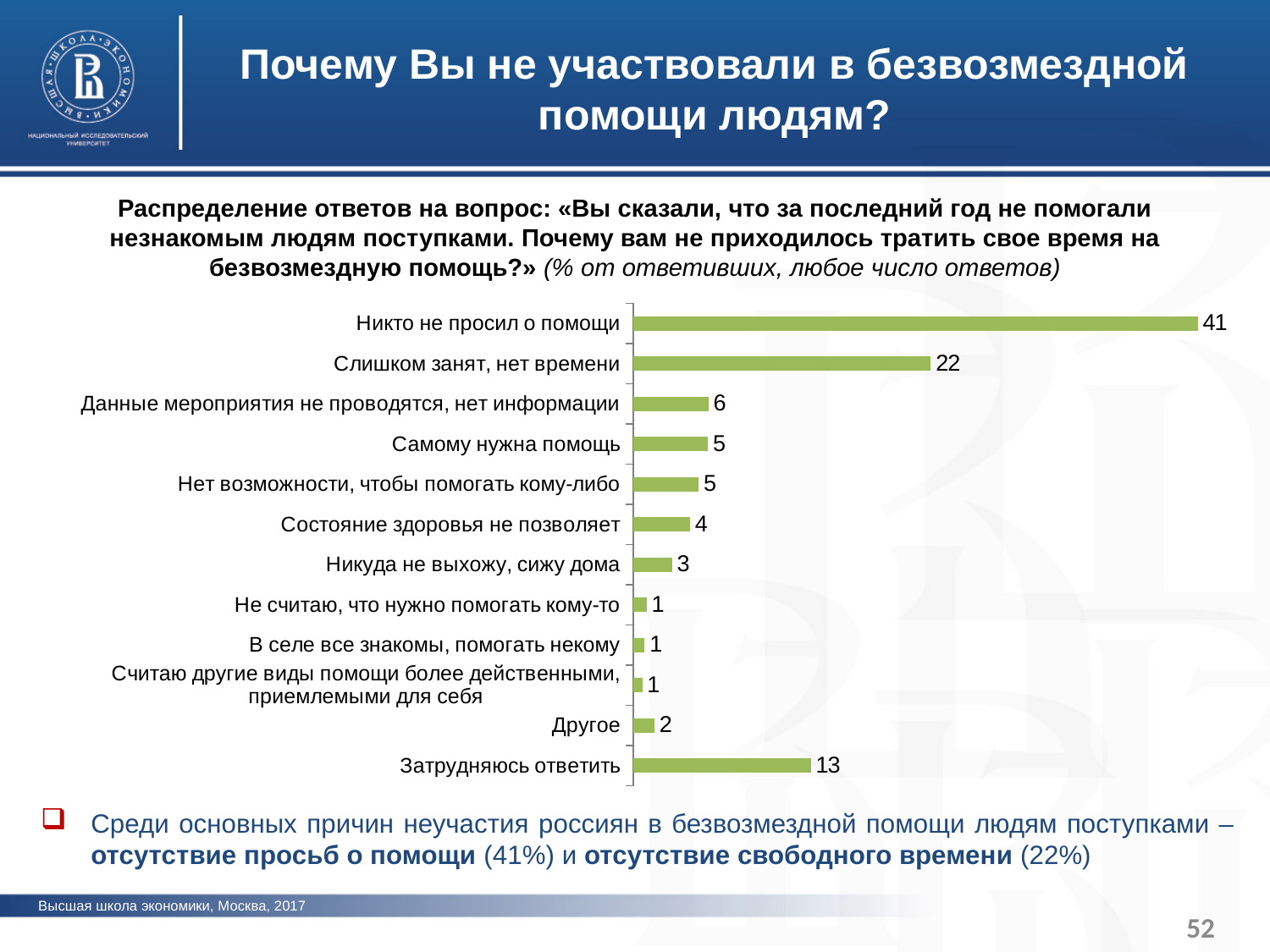
What kind of chart is shown on the slide? Bar chart Which is larger: the value for «Затрудняюсь ответить» or the value for «Данные мероприятия не проводятся, нет информации»? Затрудняюсь ответить What is the difference between the values for «Никто не просил о помощи» and «Слишком занят, нет времени»? 19 What value is shown for «Слишком занят, нет времени»? 22 What value is shown for «Состояние здоровья не позволяет»? 4 What value is shown for «Никто не просил о помощи»? 41 What is the difference between the values for «Затрудняюсь ответить» and «Никуда не выхожу, сижу дома»? 10 How many categories are shown in the chart? 12 Which category has the highest value? Никто не просил о помощи What value is shown for «Затрудняюсь ответить»? 13 What colour are the bars in the chart? Green What value is shown for «Другое»? 2